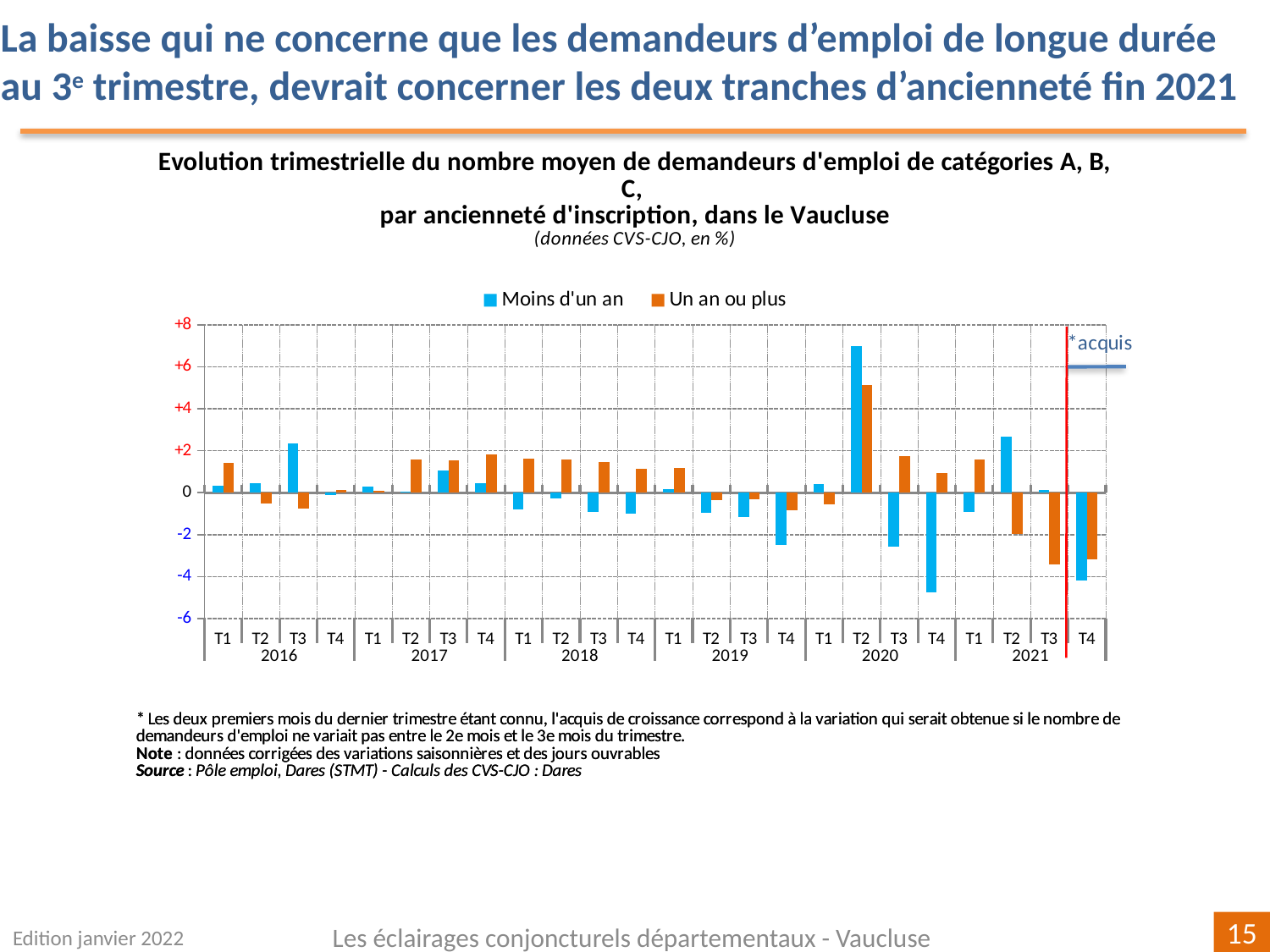
Is the value for 'Moins d'un an' in T4 2020 greater or less than -4? less How many series does the legend list? 2 In which quarter is the value for 'Moins d'un an' highest? T2 2020 Is the value for 'Un an ou plus' in T2 2020 greater or less than +4? greater What kind of chart is shown on the slide? bar chart In which quarter is the value for 'Un an ou plus' highest? T2 2020 What are the two series named in the legend? Moins d'un an; Un an ou plus In T2 2021, which series has the larger value, 'Moins d'un an' or 'Un an ou plus'? Moins d'un an In which quarter is the value for 'Moins d'un an' lowest? T4 2020 How many quarters are plotted along the x axis? 24 Which quarter is marked as 'acquis' by the red vertical line? T4 2021 Is the value for 'Moins d'un an' in T2 2020 greater or less than +6? greater